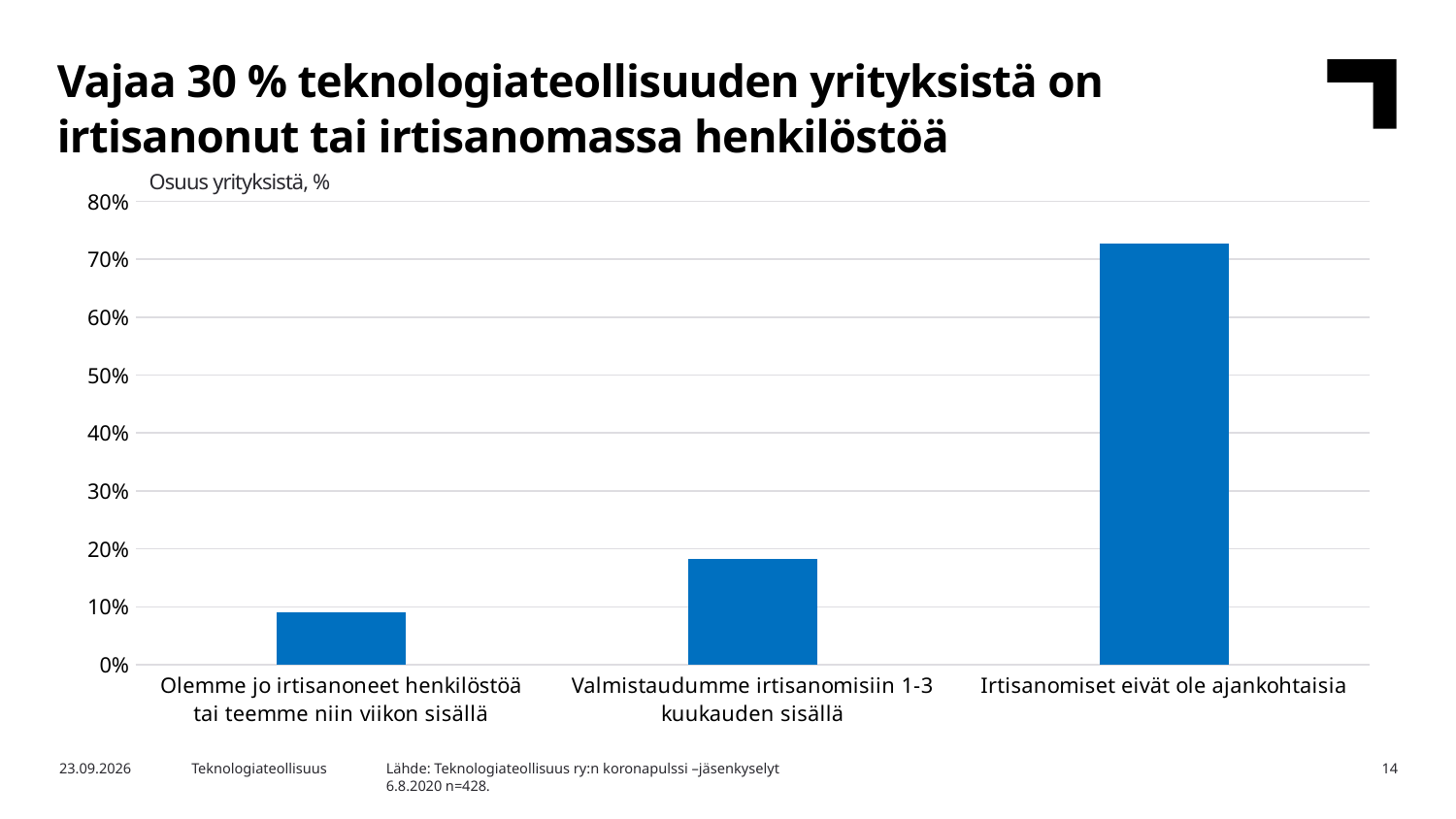
Which category has the highest value in the chart? Irtisanomiset eivät ole ajankohtaisia Is the value for 'Irtisanomiset eivät ole ajankohtaisia' greater or less than 70%? greater What kind of chart is shown on the slide? bar chart Which is larger: the value for 'Valmistaudumme irtisanomisiin 1-3 kuukauden sisällä' or the value for 'Olemme jo irtisanoneet henkilöstöä tai teemme niin viikon sisällä'? Valmistaudumme irtisanomisiin 1-3 kuukauden sisällä Is the value for 'Valmistaudumme irtisanomisiin 1-3 kuukauden sisällä' greater or less than 10%? greater Is the value for 'Valmistaudumme irtisanomisiin 1-3 kuukauden sisällä' greater or less than 20%? less What is the label shown above the vertical axis of the chart? Osuus yrityksistä, % What is the highest value shown on the vertical axis of the chart? 80% How many categories are shown on the x axis of the chart? 3 Which category has the lowest value in the chart? Olemme jo irtisanoneet henkilöstöä tai teemme niin viikon sisällä Do the bar values rise or fall from left to right along the x axis? rise